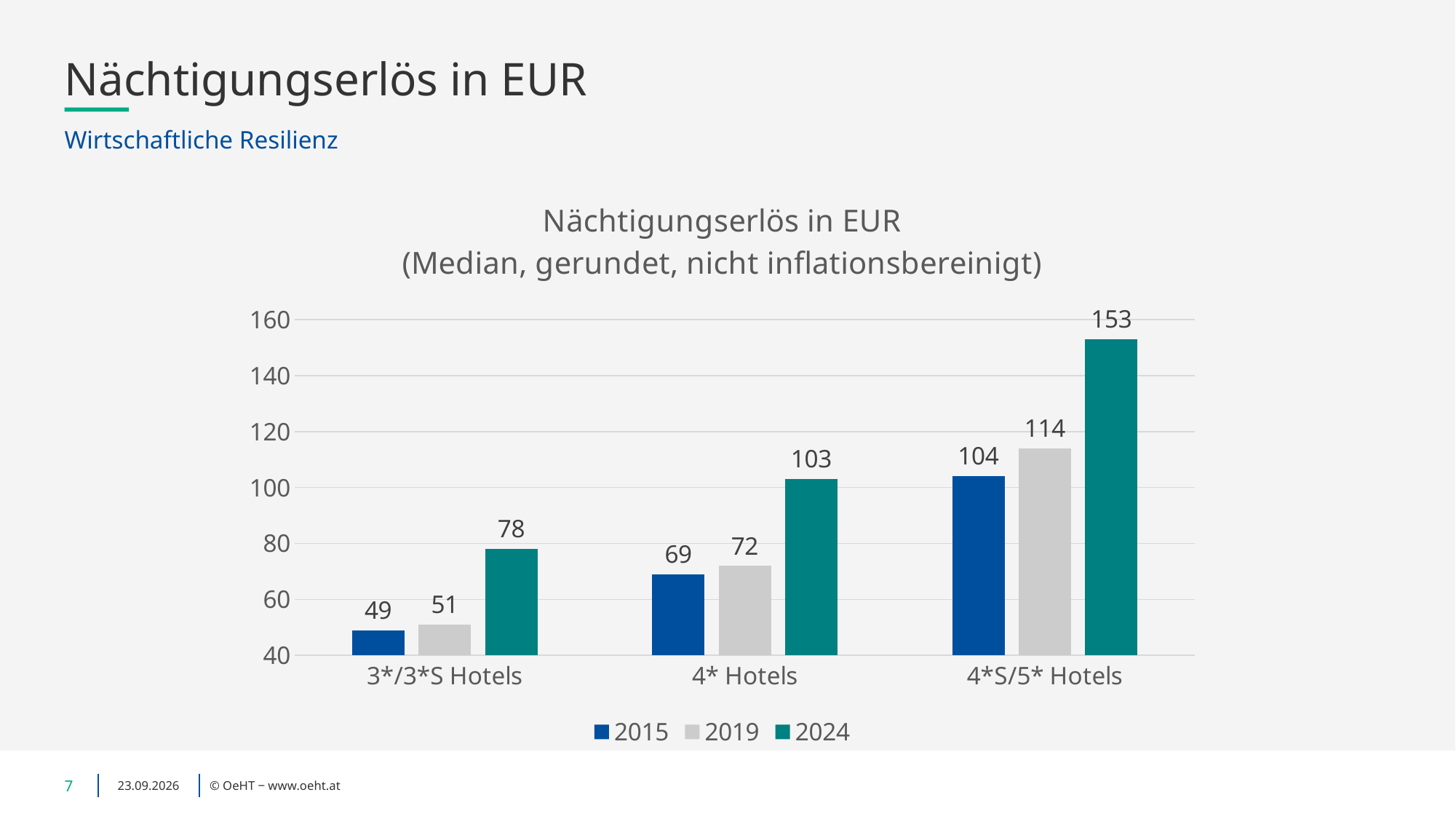
How many series does the legend list? 3 Do the 2024 values rise or fall from 3*/3*S Hotels to 4*S/5* Hotels? Rise What is the 2024 value for 4*S/5* Hotels? 153 How many hotel categories are shown on the x axis? 3 Which hotel category has the lowest 2015 value? 3*/3*S Hotels What is the 2015 value for 3*/3*S Hotels? 49 Which hotel category has the highest 2024 value? 4*S/5* Hotels What is the 2019 value for 4* Hotels? 72 What is the difference between the 2024 and 2015 values for 4*S/5* Hotels? 49 What is the difference between the 2024 values for 4* Hotels and 3*/3*S Hotels? 25 Which is larger: the 2019 value for 4*S/5* Hotels or the 2024 value for 4* Hotels? 2019 value for 4*S/5* Hotels What kind of chart is shown? Bar chart